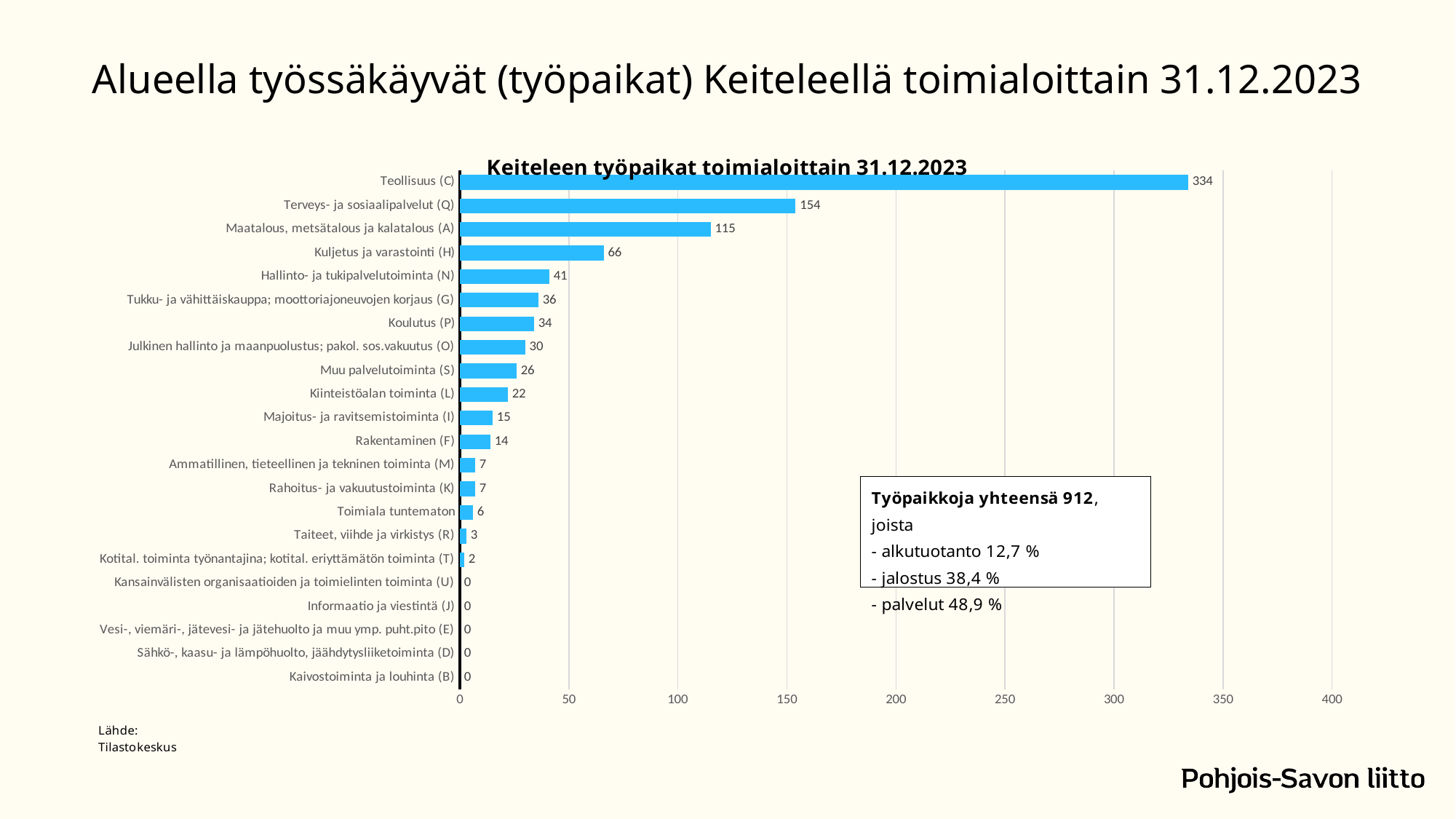
What is the value for Rakentaminen (F)? 14 What is the value for Kuljetus ja varastointi (H)? 66 Which category has the highest value? Teollisuus (C) What kind of chart is shown on the slide? Bar chart How many categories have a value of 0? 5 What is the difference between Teollisuus (C) and Terveys- ja sosiaalipalvelut (Q)? 180 How many categories are shown in the chart? 22 What is the difference between Maatalous, metsätalous ja kalatalous (A) and Kuljetus ja varastointi (H)? 49 What is the value for Terveys- ja sosiaalipalvelut (Q)? 154 What is the title of the chart? Keiteleen työpaikat toimialoittain 31.12.2023 Which is larger, Koulutus (P) or Tukku- ja vähittäiskauppa; moottoriajoneuvojen korjaus (G)? Tukku- ja vähittäiskauppa; moottoriajoneuvojen korjaus (G) What is the value for Teollisuus (C)? 334